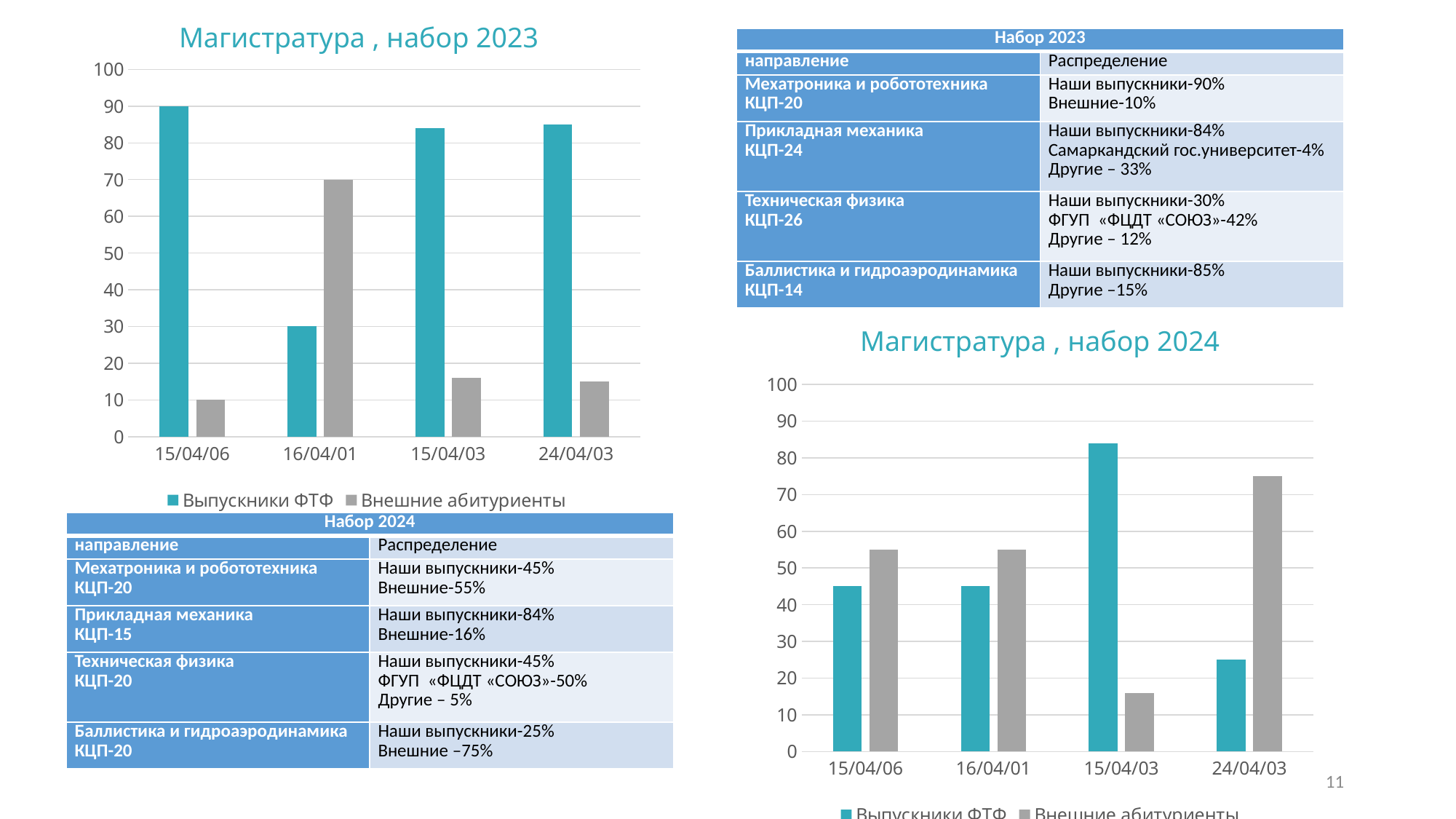
In the chart "Магистратура , набор 2024", how many series does the legend list? 2 In the chart "Магистратура , набор 2024", which series has the larger value for 15/04/06, Выпускники ФТФ or Внешние абитуриенты? Внешние абитуриенты In the chart "Магистратура , набор 2023", which category has the highest value for Выпускники ФТФ? 15/04/06 In the chart "Магистратура , набор 2023", what is the value of Выпускники ФТФ for 15/04/06? 90 In the chart "Магистратура , набор 2024", is the value of Выпускники ФТФ for 15/04/03 greater or less than 80? greater What kind of chart is "Магистратура , набор 2023"? bar chart In the chart "Магистратура , набор 2023", what is the difference between Выпускники ФТФ and Внешние абитуриенты for 15/04/06? 80 In the chart "Магистратура , набор 2023", which category has the highest value for Внешние абитуриенты? 16/04/01 In the chart "Магистратура , набор 2023", what is the value of Внешние абитуриенты for 16/04/01? 70 How many categories are shown on the x axis of the chart "Магистратура , набор 2023"? 4 In the chart "Магистратура , набор 2024", which category has the highest value for Выпускники ФТФ? 15/04/03 In the chart "Магистратура , набор 2024", is the value of Внешние абитуриенты for 24/04/03 greater or less than 70? greater